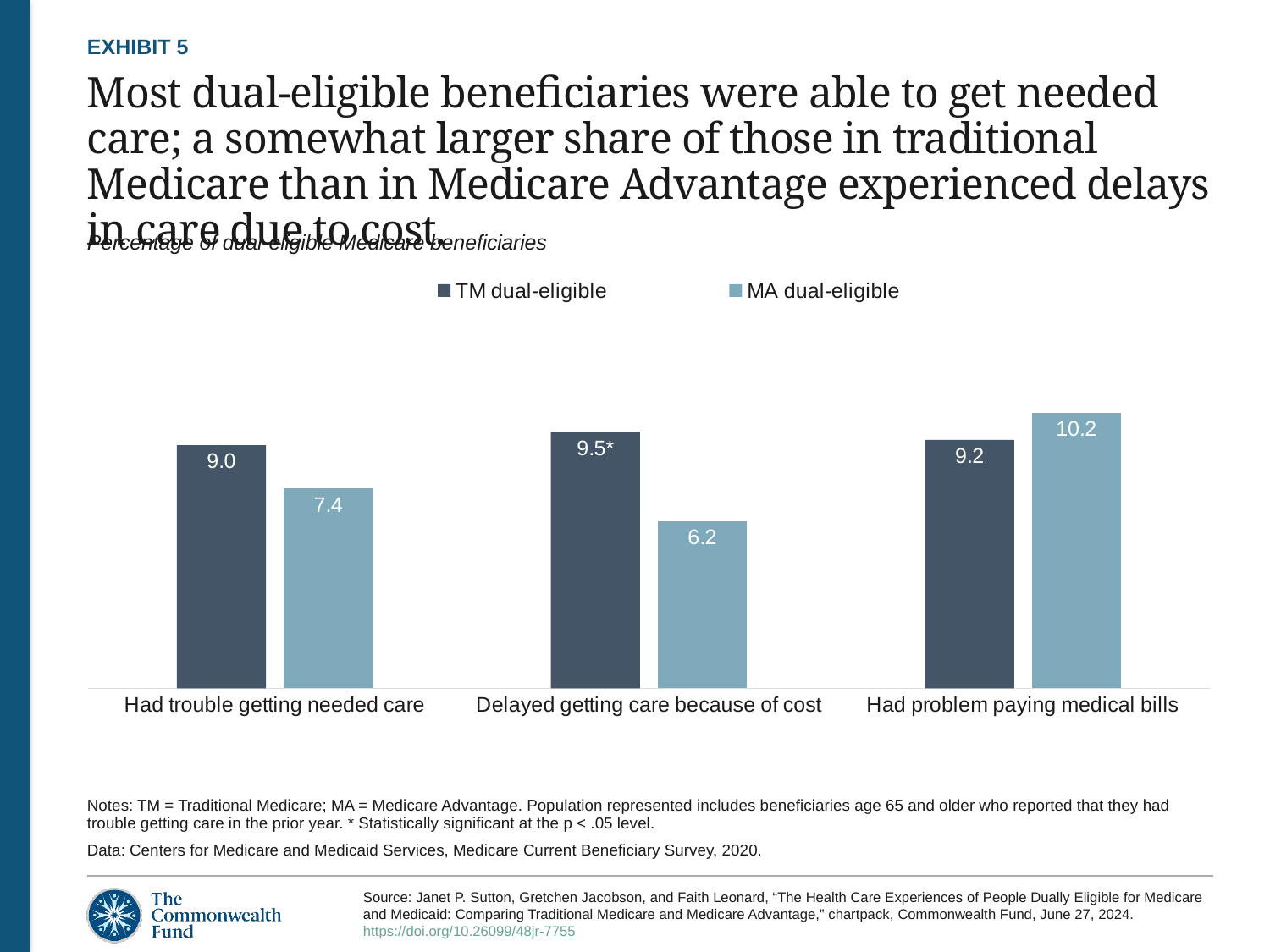
What is the difference between the TM dual-eligible and MA dual-eligible values for 'Delayed getting care because of cost'? 3.3 For 'Had problem paying medical bills', which series has the larger value, TM dual-eligible or MA dual-eligible? MA dual-eligible How many categories are shown on the x axis? 3 What is the value for TM dual-eligible for 'Had trouble getting needed care'? 9.0 What kind of chart is shown on the slide? Bar chart What is the value for MA dual-eligible for 'Delayed getting care because of cost'? 6.2 Which category has the highest MA dual-eligible value? Had problem paying medical bills What is the value for TM dual-eligible for 'Delayed getting care because of cost'? 9.5* What is the value for MA dual-eligible for 'Had problem paying medical bills'? 10.2 What are the two series named in the legend? TM dual-eligible and MA dual-eligible Which category has the lowest MA dual-eligible value? Delayed getting care because of cost How many series does the legend list? 2